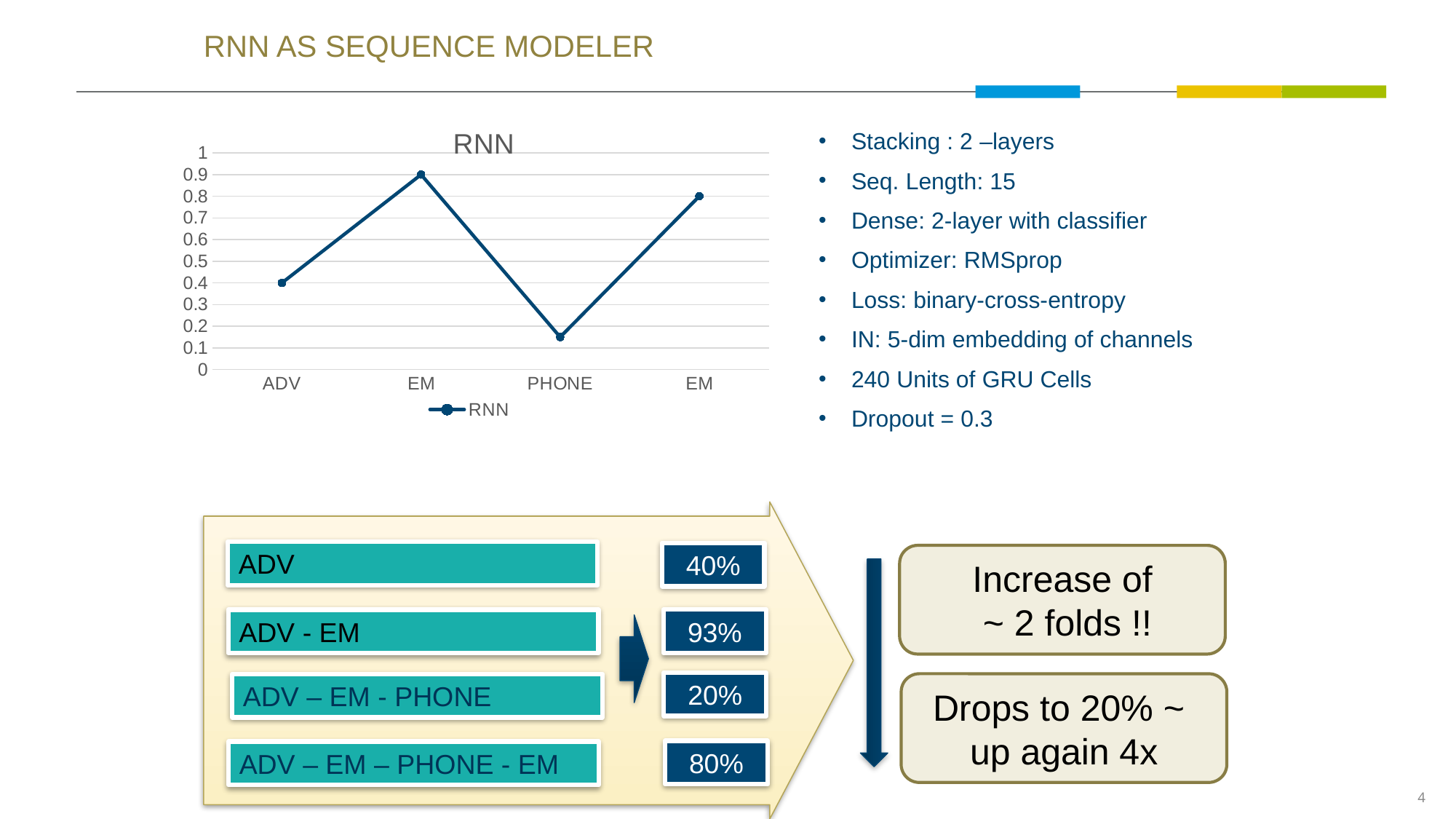
What is the value for the second category, EM, on the RNN chart? 0.9 On the RNN chart, does the value rise or fall from the second category, EM, to PHONE? fall How many data points are plotted on the RNN line chart? 4 On the RNN chart, which is larger: the value for ADV or the value for the last category, EM? EM (last category) Which category has the lowest value on the RNN chart? PHONE Which category has the highest value on the RNN chart? EM (second category) Is the value for PHONE on the RNN chart greater or less than 0.5? less What kind of chart is shown under the title "RNN"? line chart What is the value for ADV on the RNN chart? 0.4 What is the value for the last category, EM, on the RNN chart? 0.8 How many series does the legend of the RNN chart list? 1 What is the difference between the value for the second category, EM, and the value for ADV on the RNN chart? 0.5